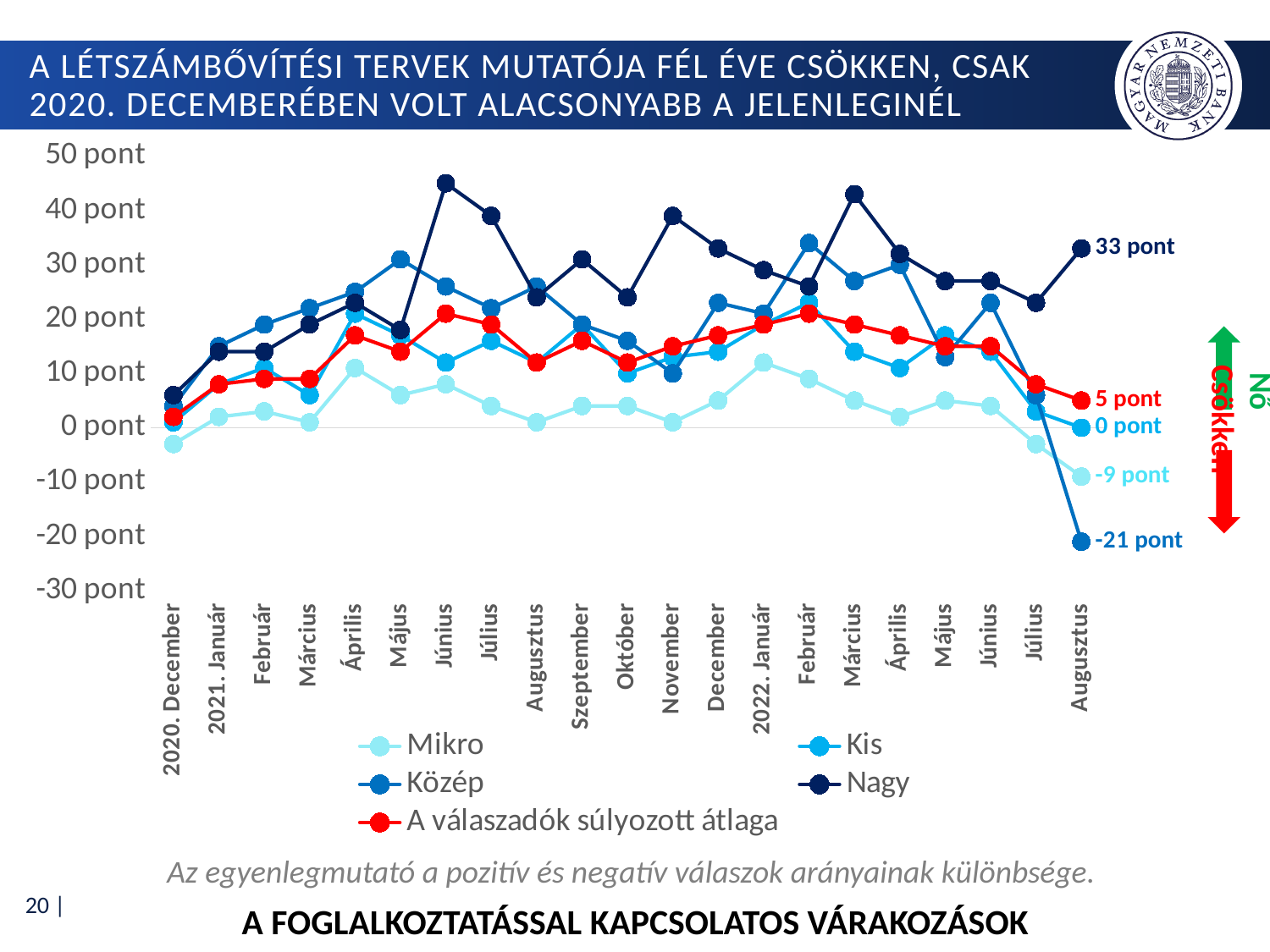
How many time points are plotted along the x axis? 21 Which series has the lowest value in Augusztus (2022)? Közép What kind of chart is shown on the slide? line chart What is the value for the Mikro series in Augusztus (2022)? -9 pont What is the value for the Kis series in Augusztus (2022)? 0 pont Does the 'A válaszadók súlyozott átlaga' series rise or fall from 2022 Február to Augusztus? fall What is the value for the Nagy series in Augusztus (2022)? 33 pont What is the difference between the Nagy and Közép values in Augusztus (2022)? 54 pont What is the value of 'A válaszadók súlyozott átlaga' in Augusztus (2022)? 5 pont How many series does the legend list? 5 What is the value for the Közép series in Augusztus (2022)? -21 pont Is the value for the Nagy series in 2021 Június greater or less than 40 pont? greater